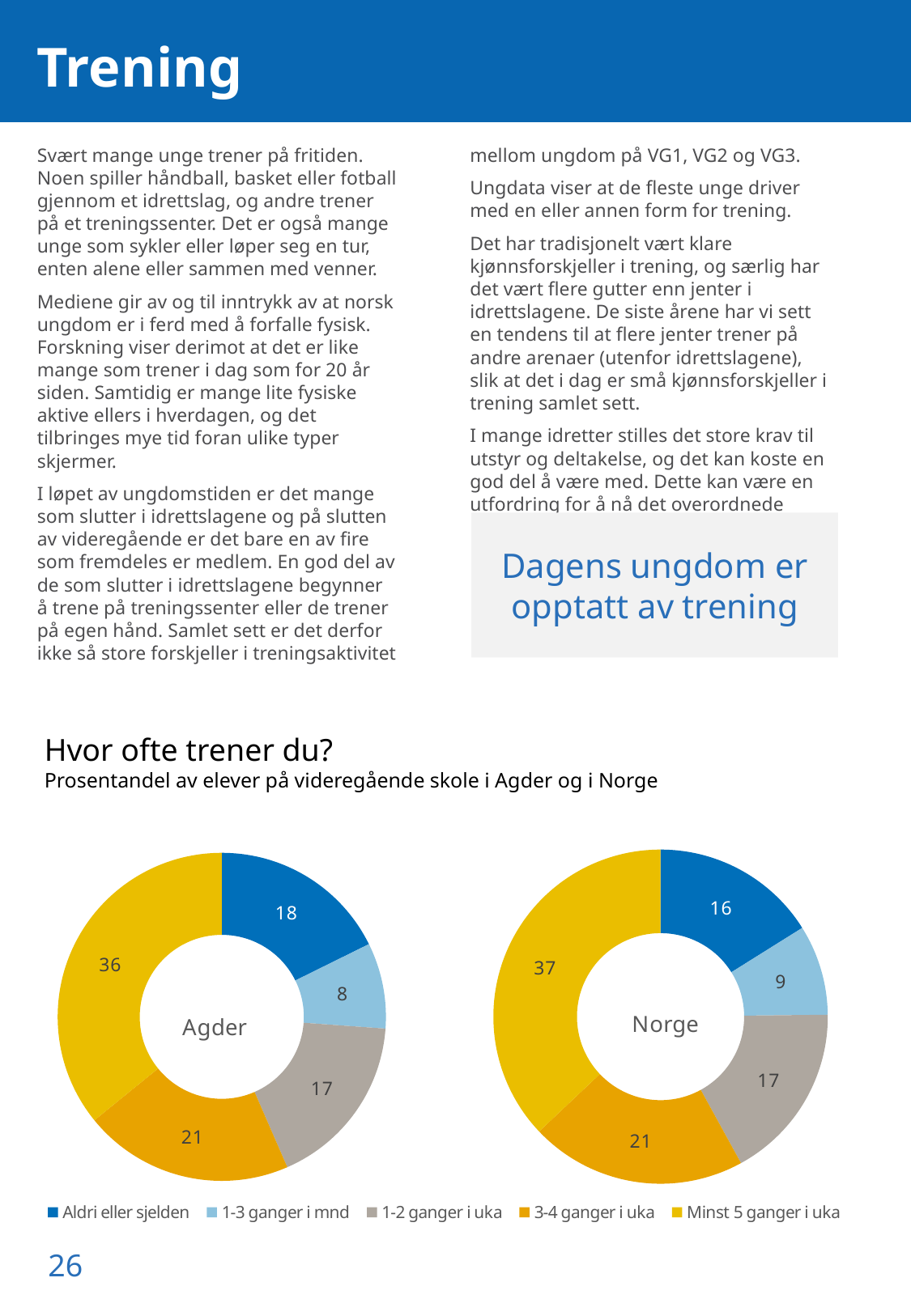
In the Norge chart, what is the value for '3-4 ganger i uka'? 21 In the Norge chart, what is the value for 'Aldri eller sjelden'? 16 In the Agder chart, what is the value for 'Minst 5 ganger i uka'? 36 What is the title of the chart section on the slide? Hvor ofte trener du? In the Norge chart, which category has the smallest share? 1-3 ganger i mnd In the Agder chart, what is the difference between 'Aldri eller sjelden' and '1-3 ganger i mnd'? 10 How many categories does each donut chart show? 5 In the Agder chart, what is the value for '1-3 ganger i mnd'? 8 What kind of chart is used to show the Agder and Norge data? Donut (pie) chart Which is larger: 'Aldri eller sjelden' in the Agder chart or in the Norge chart? Agder What is the difference between the 'Minst 5 ganger i uka' values in the Norge chart and the Agder chart? 1 In the Agder chart, which category has the largest share? Minst 5 ganger i uka